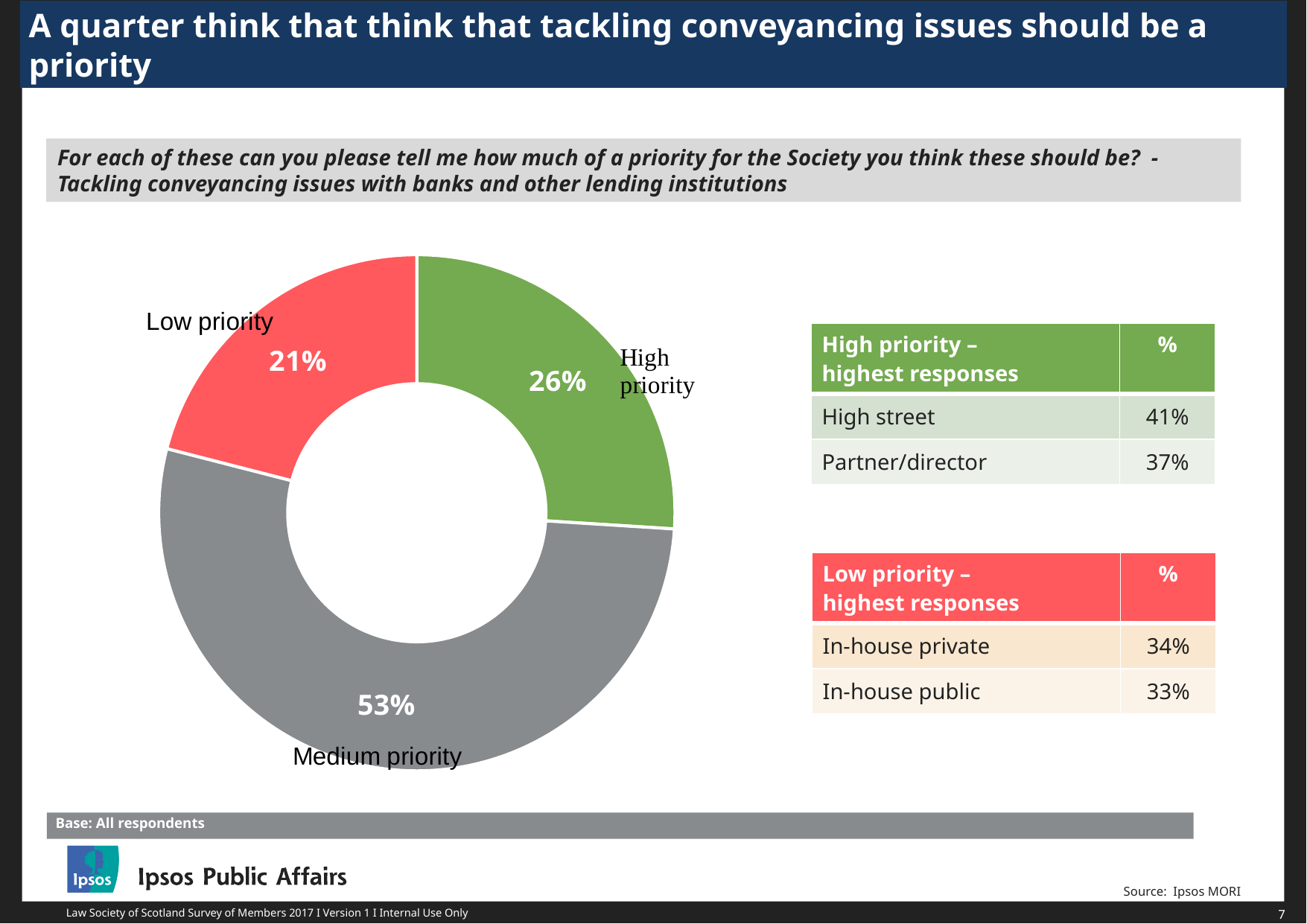
What colour is the high priority slice of the donut chart? Green What percentage of respondents said tackling conveyancing issues should be a low priority? 21% What colour is the medium priority slice of the donut chart? Grey What is the combined share of the high priority and low priority slices? 47% How many slices does the donut chart have? 3 Which priority level has the largest share of the donut chart? Medium priority Which is larger, the high priority slice or the low priority slice? High priority What percentage of respondents said tackling conveyancing issues should be a medium priority? 53% What percentage of respondents said tackling conveyancing issues should be a high priority? 26% What kind of chart is shown on the slide? Donut (pie) chart Which priority level has the smallest share of the donut chart? Low priority What is the difference in percentage points between the medium priority and high priority slices? 27